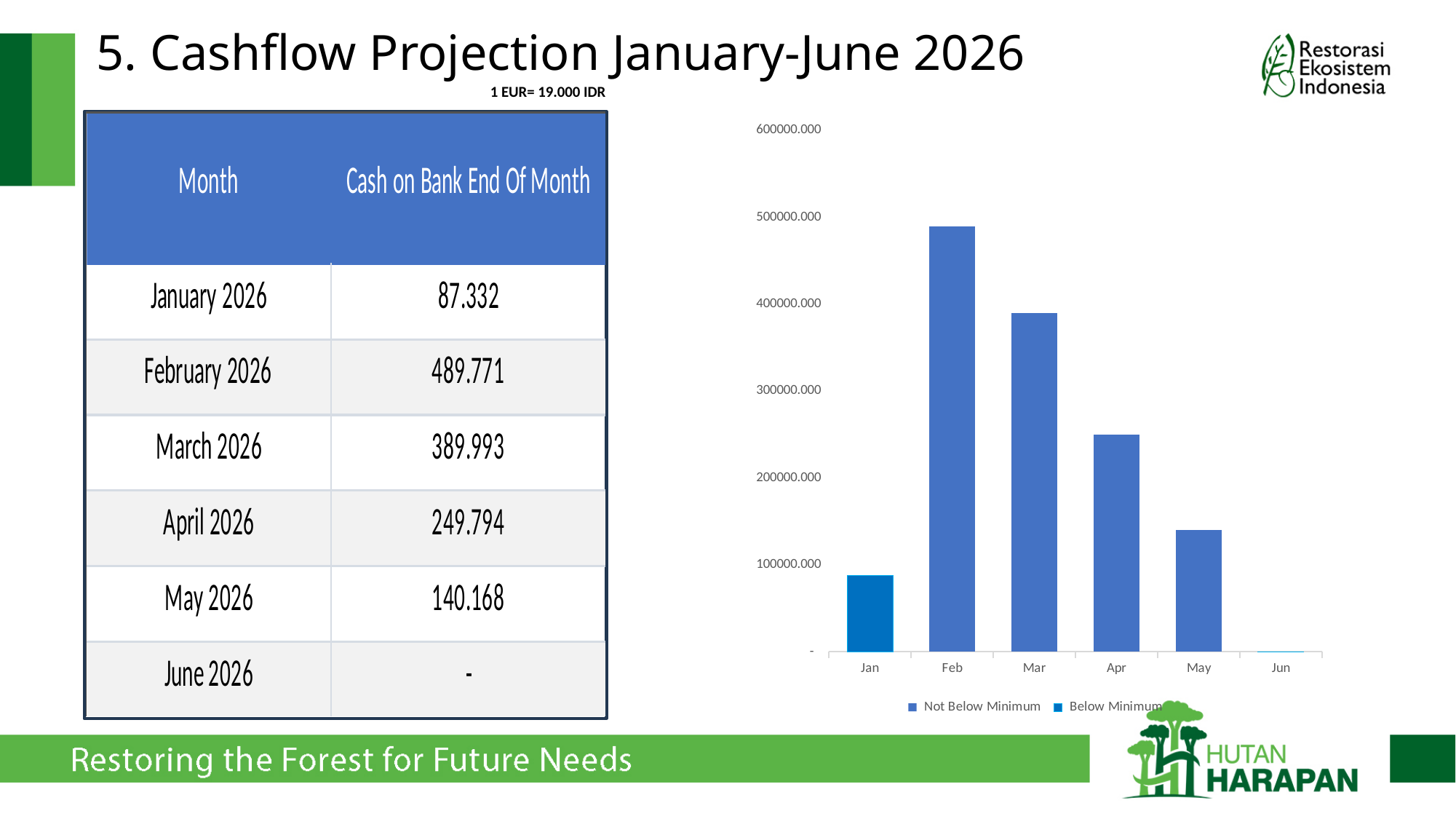
Which is larger, the bar for Mar or the bar for Apr? Mar Which month has the highest bar in the chart? Feb What kind of chart is shown on the right of the slide? bar chart Is the value for Apr greater or less than 300000.000? less Is the value for Feb greater or less than 400000.000? greater Which month has the lowest bar in the chart? Jun How many months are shown on the x axis of the chart? 6 Is the value for Jan greater or less than 100000.000? less How many series does the chart legend list? 2 Do the bars rise or fall from Feb to Jun? fall Which month's bar belongs to the 'Below Minimum' series? Jan